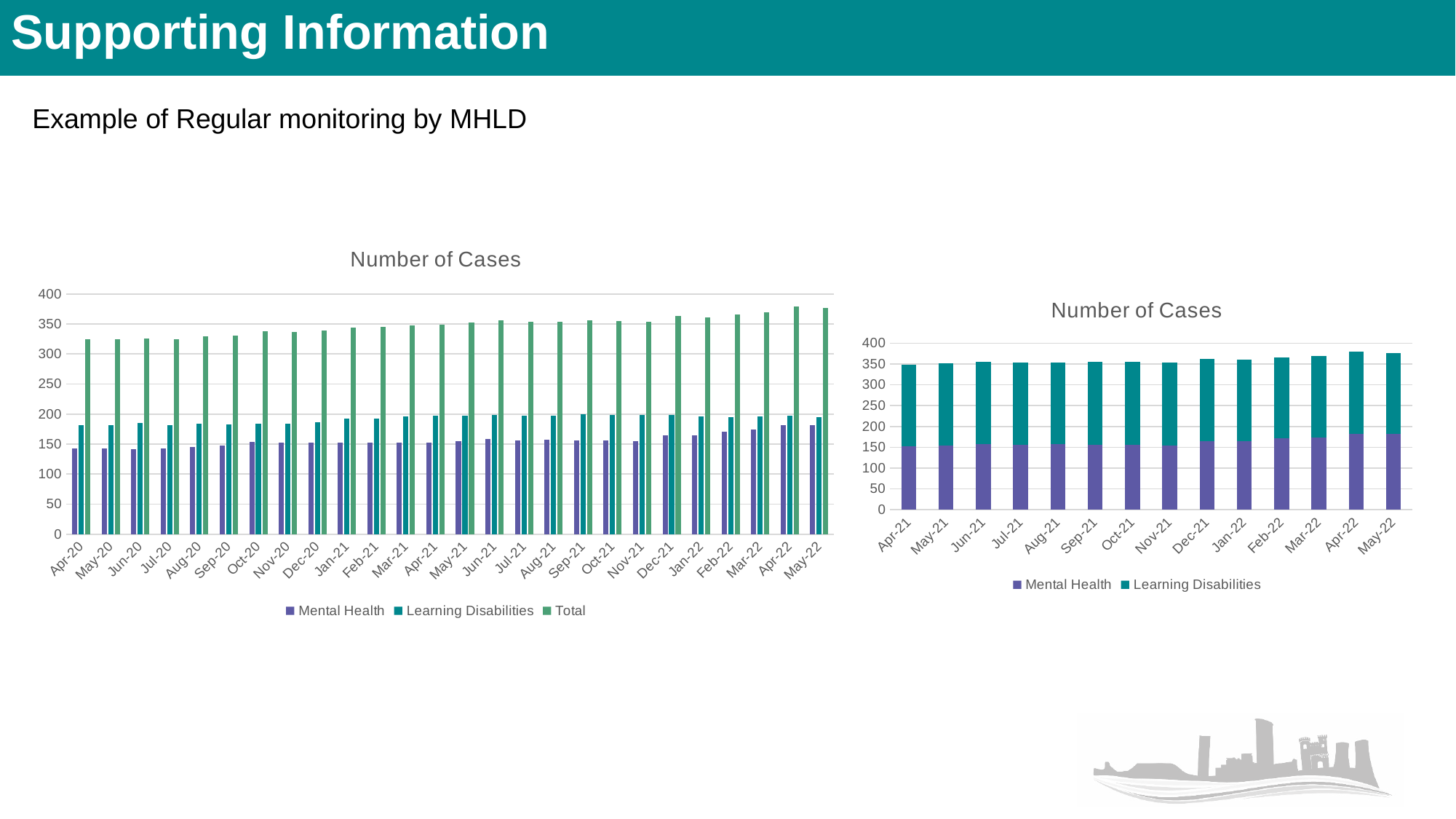
How many months are shown on the x axis of the left chart? 26 What is the title of the chart on the right of the slide? Number of Cases How many series does the legend of the left chart list? 3 In the left chart, which is larger: the Total for Apr-20 or the Total for Apr-22? Apr-22 How many series does the legend of the right chart list? 2 In the right chart, which segment is larger for Apr-21: Mental Health or Learning Disabilities? Learning Disabilities How many months are shown on the x axis of the right chart? 14 In the left chart, is the Total value for Apr-20 greater or less than 300? greater In the left chart, is the Total value for Apr-22 greater or less than 350? greater In the left chart, is the Mental Health value for Apr-20 greater or less than 150? less In the left chart, does the Total series generally rise or fall from Apr-20 to May-22? rise What type of chart is the chart on the left of the slide? Bar chart